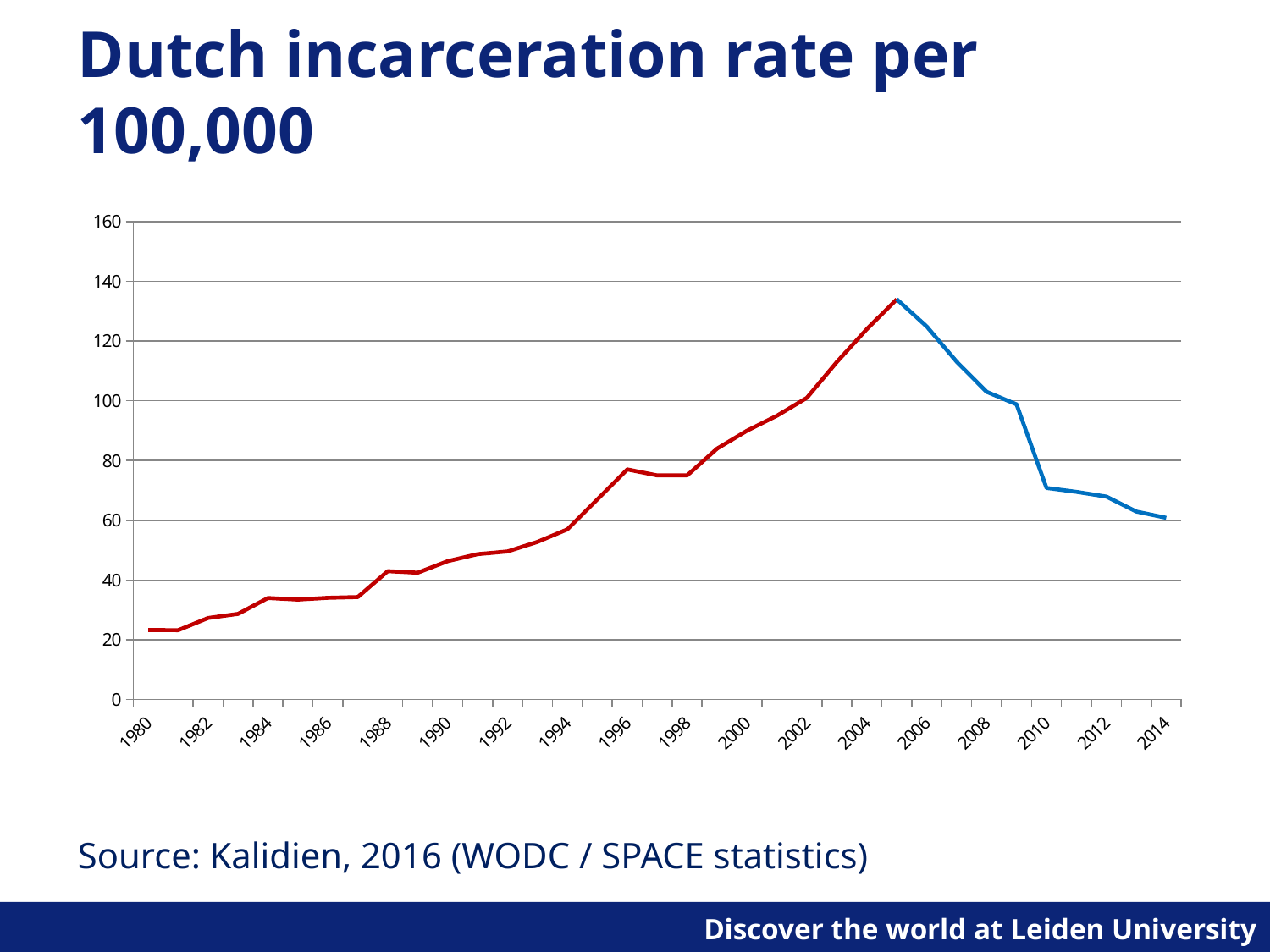
Is the value for 2010 greater or less than 80? less Does the incarceration rate rise or fall between 1980 and 2005? rise Is the value for 2005 greater or less than 120? greater Does the incarceration rate rise or fall between 2005 and 2014? fall Is the value for 2014 greater or less than 80? less What is the title of the chart? Dutch incarceration rate per 100,000 Which year has the larger value, 1980 or 1990? 1990 Which year has the larger value, 2005 or 2014? 2005 What kind of chart is shown on the slide? line chart In which year does the incarceration rate reach its highest point? 2005